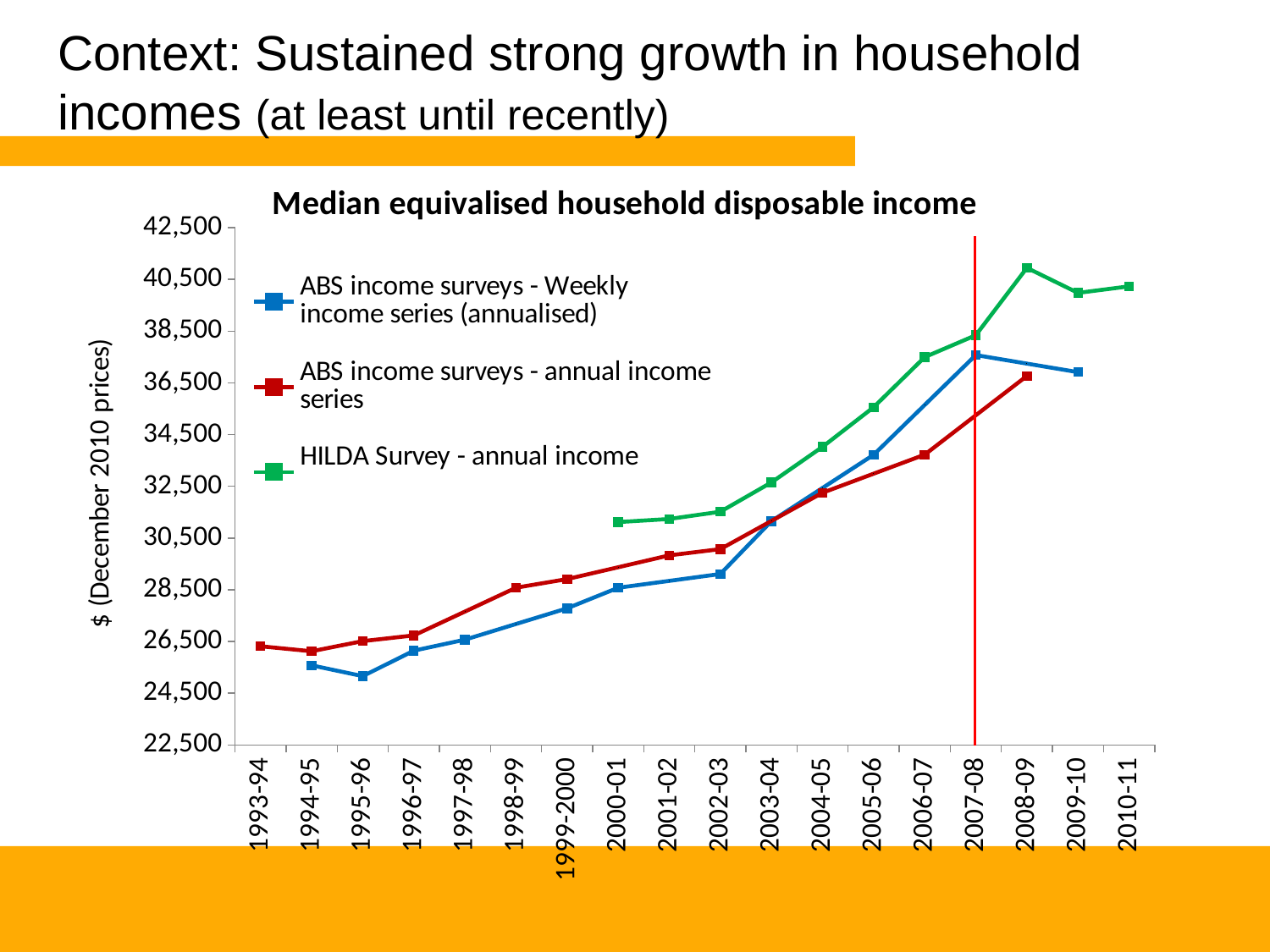
Is the ABS income surveys - annual income series value for 1993-94 greater or less than 28,500? less Which series reaches the highest value on the chart? HILDA Survey - annual income What is the title of the chart? Median equivalised household disposable income What is the label on the y axis? $ (December 2010 prices) Is the HILDA Survey - annual income value for 2000-01 greater or less than 30,500? greater Is the HILDA Survey - annual income value for 2008-09 greater or less than 38,500? greater How many series does the legend list? 3 How many financial years are labelled on the x axis? 18 In which year does the ABS income surveys - Weekly income series (annualised) reach its lowest value? 1995-96 What type of chart is shown on the slide? Line chart In 2005-06, which is larger: the HILDA Survey - annual income value or the ABS income surveys - Weekly income series (annualised) value? HILDA Survey - annual income